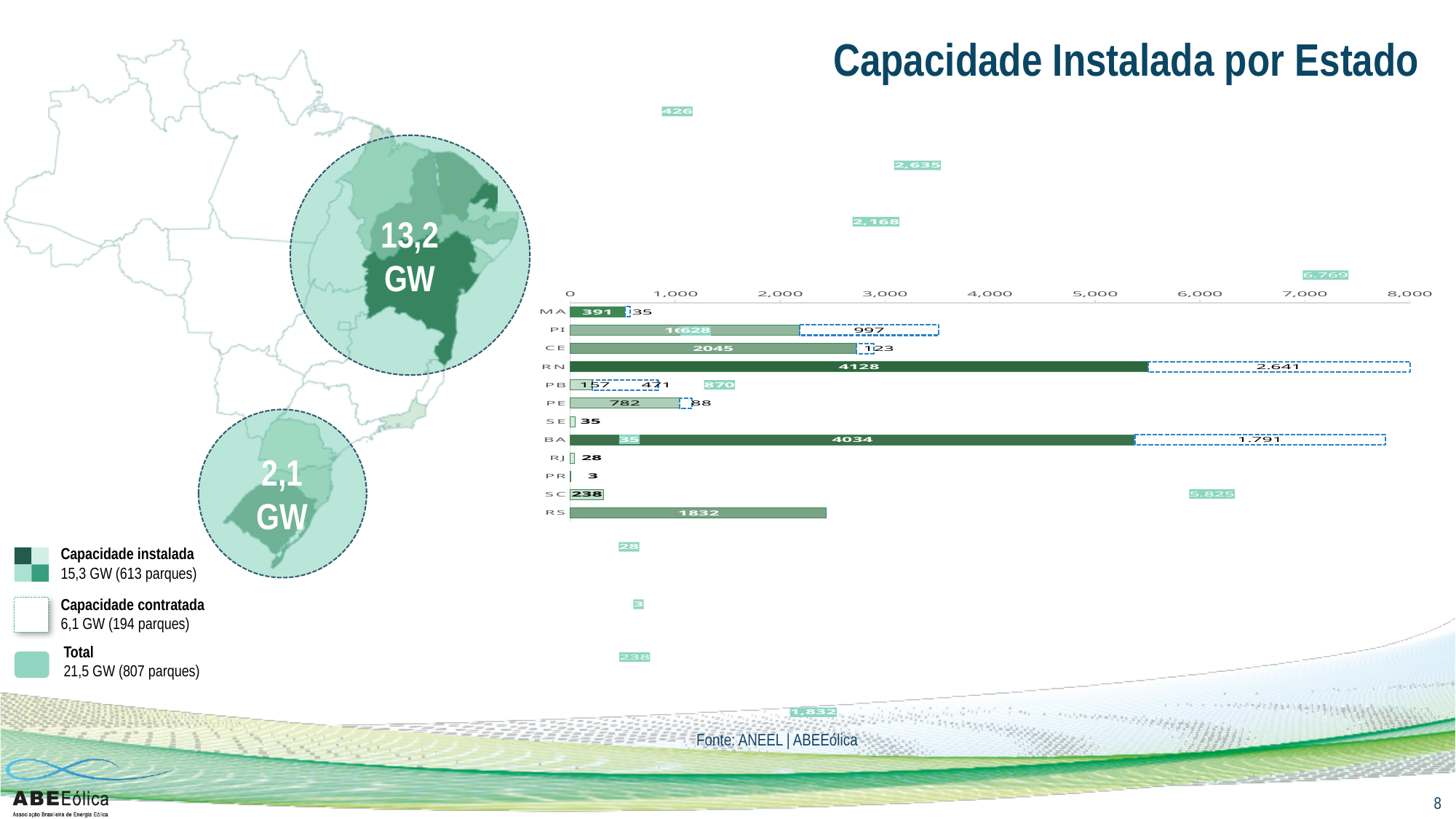
Which state has a larger installed capacity value, CE or PI? CE What is the difference between the installed capacity values of CE and PI? 407 Is the installed capacity value for RN greater or less than 4,000? greater How many states are listed on the vertical axis of the bar chart? 12 What is the installed capacity value shown for CE in the bar chart? 2045 What is the installed capacity value shown for RS in the bar chart? 1832 What kind of chart is shown on the slide? bar chart What is the highest value shown on the horizontal axis of the bar chart? 8,000 What is the installed capacity value shown for RN in the bar chart? 4128 What is the installed capacity value shown for PE in the bar chart? 782 What is the title of the slide? Capacidade Instalada por Estado Which state has the lowest installed capacity value in the bar chart? PR